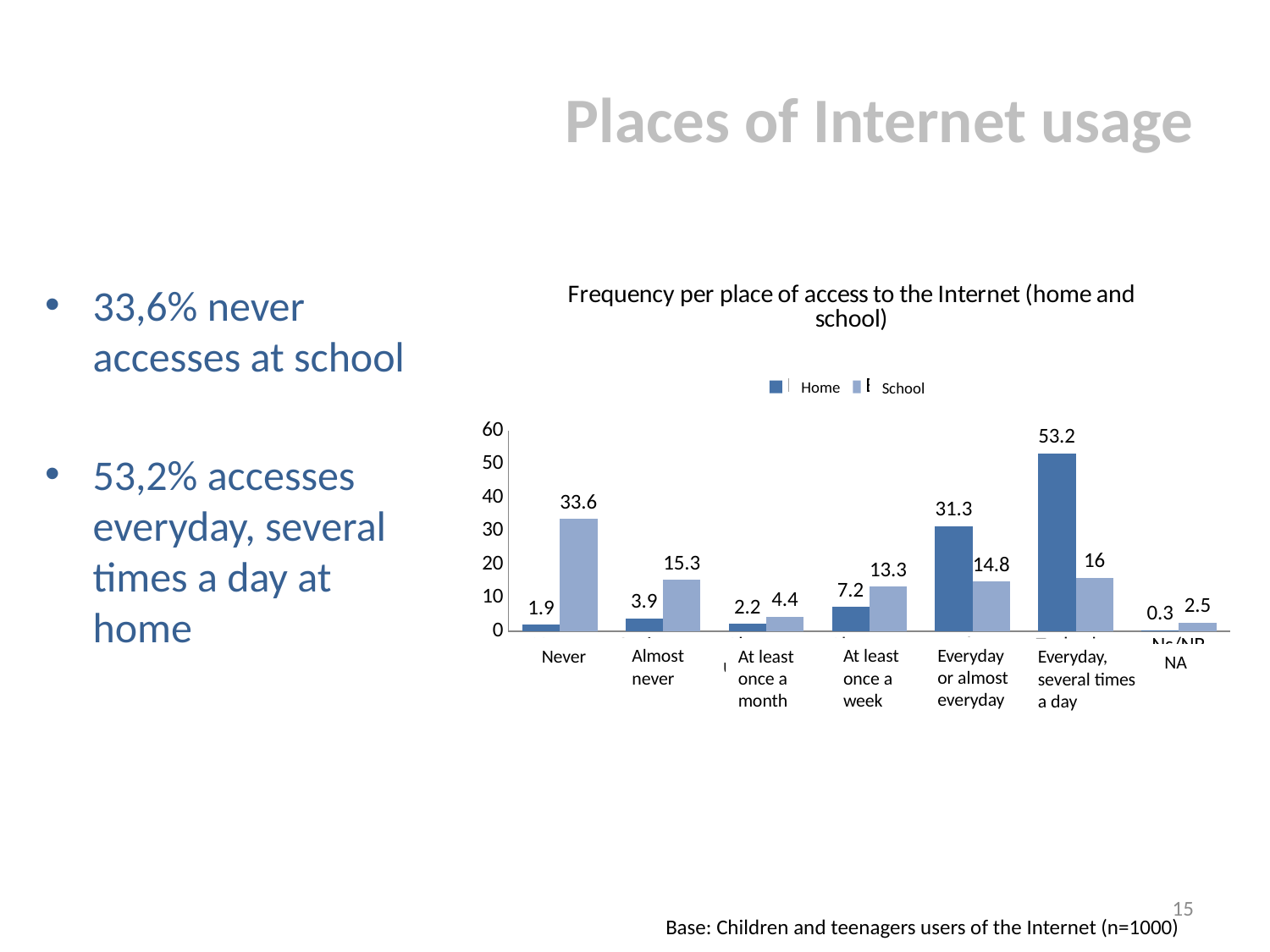
Which category has the highest Home value? Everyday, several times a day What is the Home value for the 'Never' category? 1.9 Which category has the lowest School value? NA What is the difference between the Home and School values for 'Everyday or almost everyday'? 16.5 What is the Home value for 'Everyday, several times a day'? 53.2 What is the School value for 'At least once a week'? 13.3 For the 'Almost never' category, which is larger, the Home value or the School value? School How many categories are shown on the x axis? 7 What is the title of the chart? Frequency per place of access to the Internet (home and school) How many series does the legend list? 2 What is the School value for the 'Never' category? 33.6 What kind of chart is shown on the slide? Bar chart